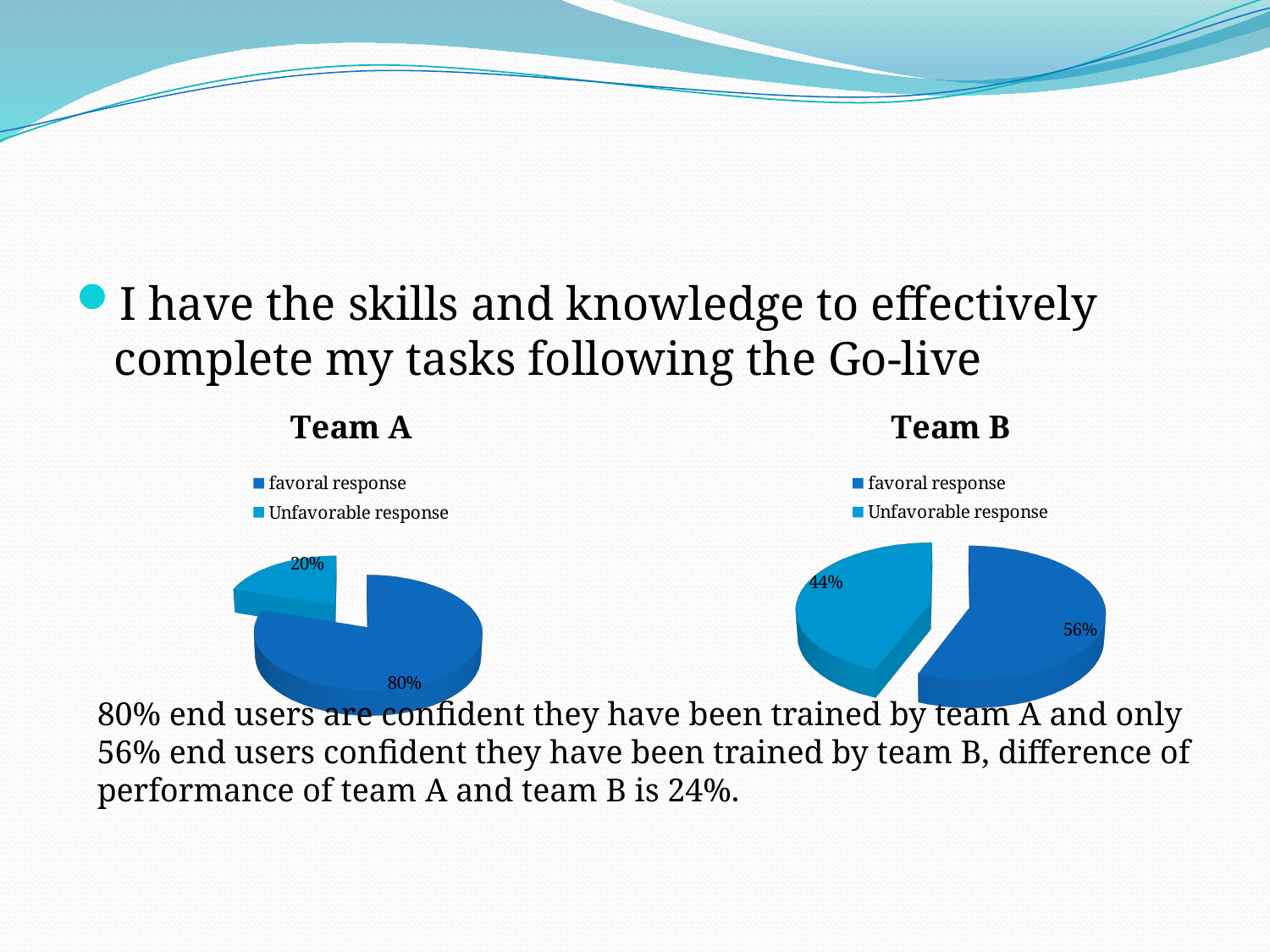
In the Team A chart, what percentage is the favoral response slice? 80% What is the title of the chart on the right side of the slide? Team B How many slices does the Team B chart have? 2 How many entries does the legend of the Team A chart list? 2 In the Team B chart, what percentage is the favoral response slice? 56% In the Team B chart, which slice is the smallest? Unfavorable response What is the difference between the favoral response share in the Team A chart and the favoral response share in the Team B chart? 24% In the Team A chart, what percentage is the Unfavorable response slice? 20% What type of chart is the Team A chart? pie chart In the Team A chart, which slice is the largest? favoral response Which chart has the larger Unfavorable response slice, Team A or Team B? Team B In the Team B chart, what percentage is the Unfavorable response slice? 44%